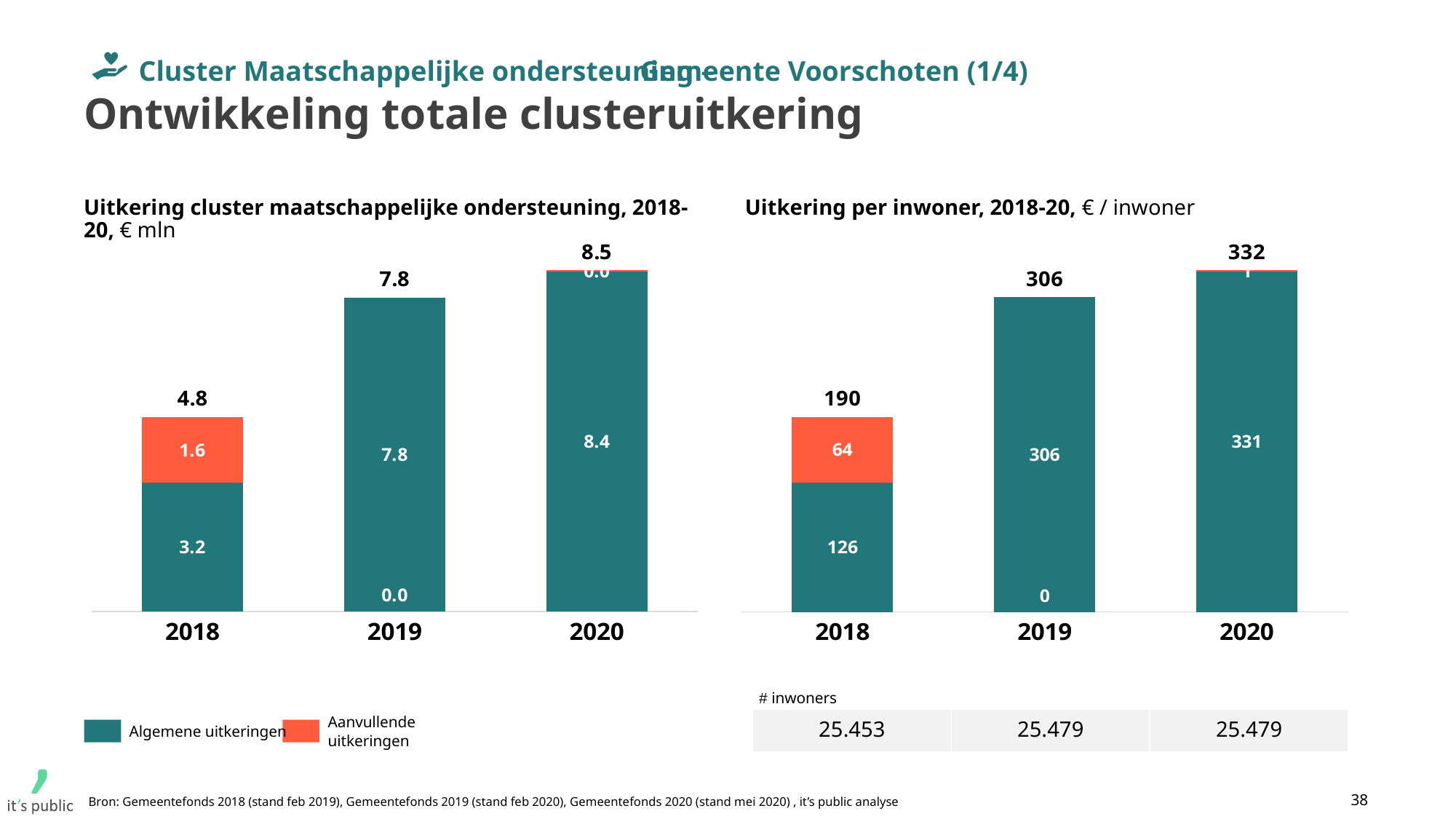
In the right chart (Uitkering per inwoner), do the total values rise or fall from 2018 to 2020? rise In the right chart (Uitkering per inwoner), what is the value of Algemene uitkeringen for 2019? 306 In the right chart (Uitkering per inwoner), what is the total of the stacked bar for 2018? 190 In the right chart (Uitkering per inwoner), which year has the highest total uitkering per inwoner? 2020 In the left chart (Uitkering cluster maatschappelijke ondersteuning), what is the value of Algemene uitkeringen for 2018? 3.2 In the left chart (Uitkering cluster maatschappelijke ondersteuning), what is the difference between the Algemene uitkeringen for 2020 and 2019? 0.6 In the left chart (Uitkering cluster maatschappelijke ondersteuning), what is the value of Aanvullende uitkeringen for 2018? 1.6 In the right chart (Uitkering per inwoner), what is the value of Aanvullende uitkeringen for 2018? 64 In the left chart (Uitkering cluster maatschappelijke ondersteuning), which year has the lowest total uitkering? 2018 In the left chart (Uitkering cluster maatschappelijke ondersteuning), what is the total of the stacked bar for 2020? 8.5 How many series does the legend list for the left chart? 2 What kind of chart is the right chart (Uitkering per inwoner)? stacked bar chart